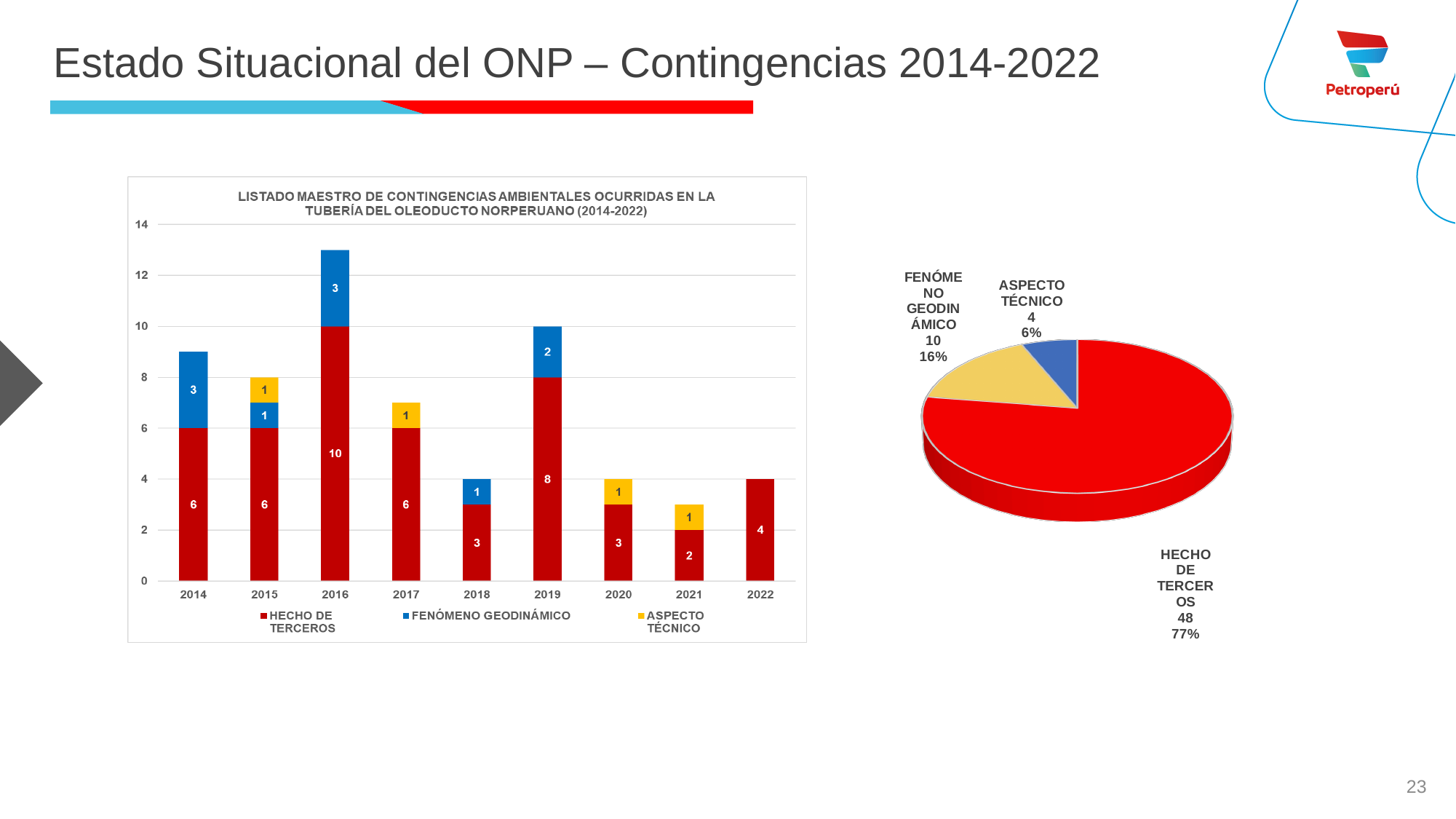
In the pie chart on the right, what share does HECHO DE TERCEROS have? 77% In the bar chart on the left, how many years are shown on the x axis? 9 In the bar chart on the left, what is the difference between HECHO DE TERCEROS in 2019 and in 2018? 5 In the bar chart on the left, what is the value for ASPECTO TÉCNICO in 2021? 1 In the pie chart on the right, what is the value for FENÓMENO GEODINÁMICO? 10 In the bar chart on the left, what is the total of the stacked bar for 2014? 9 In the bar chart on the left, which year has the lowest total stacked bar? 2021 In the bar chart on the left, which year has the highest total stacked bar? 2016 In the bar chart on the left, how many series does the legend list? 3 In the bar chart on the left, what is the value for FENÓMENO GEODINÁMICO in 2019? 2 In the bar chart on the left, what is the value for HECHO DE TERCEROS in 2016? 10 What kind of chart is shown on the right of the slide? Pie chart